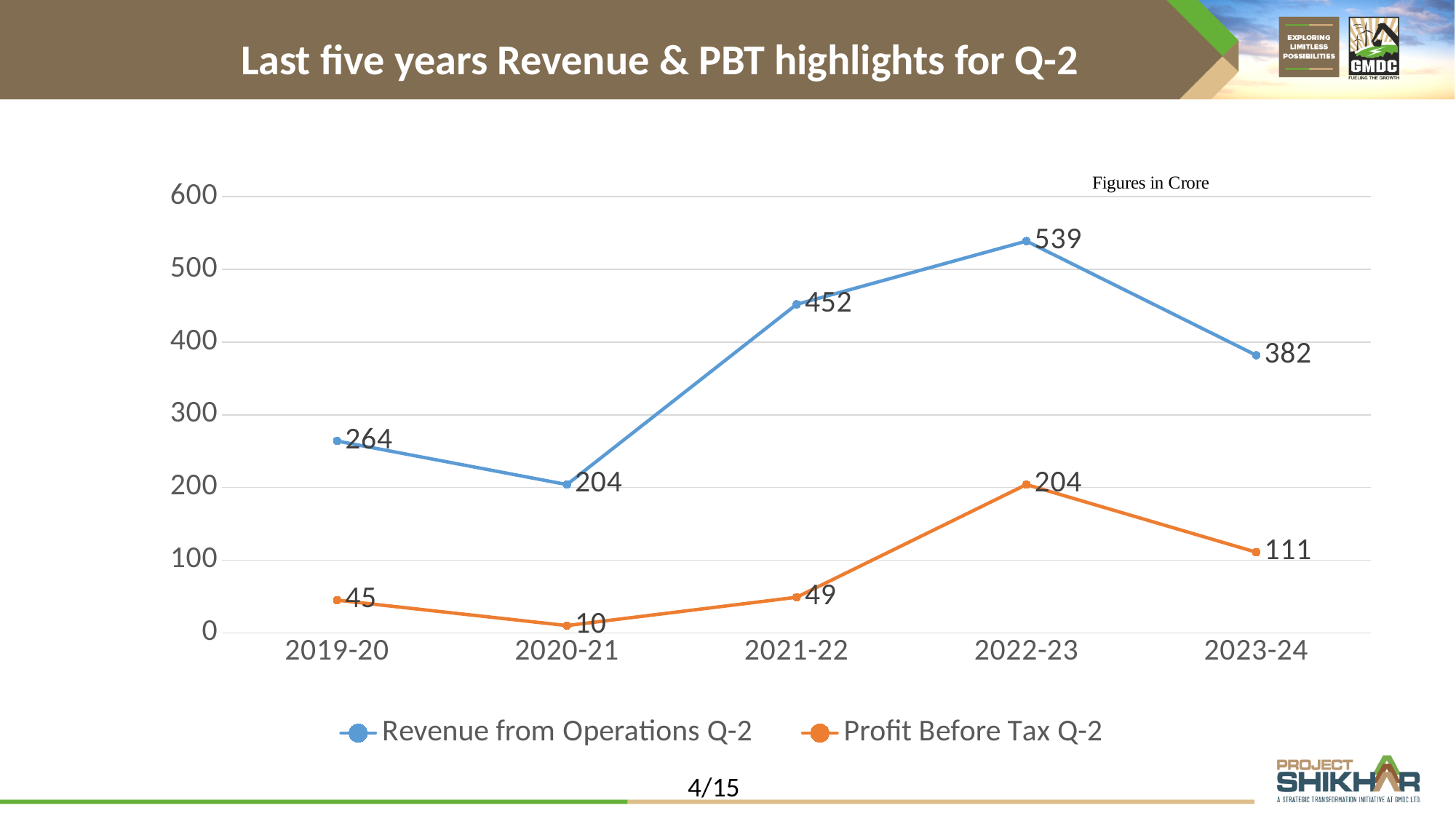
What is the difference between Profit Before Tax Q-2 in 2022-23 and 2021-22? 155 What is the Profit Before Tax Q-2 value for 2020-21? 10 How many years are shown on the x axis? 5 Which is larger: Revenue from Operations Q-2 in 2019-20 or in 2021-22? 2021-22 What is the Revenue from Operations Q-2 value for 2022-23? 539 In which year is Revenue from Operations Q-2 highest? 2022-23 How many series does the legend list? 2 What unit note is printed above the chart? Figures in Crore What is the Profit Before Tax Q-2 value for 2023-24? 111 In which year is Profit Before Tax Q-2 lowest? 2020-21 What kind of chart is shown on the slide? Line chart What is the difference between Revenue from Operations Q-2 in 2022-23 and 2023-24? 157